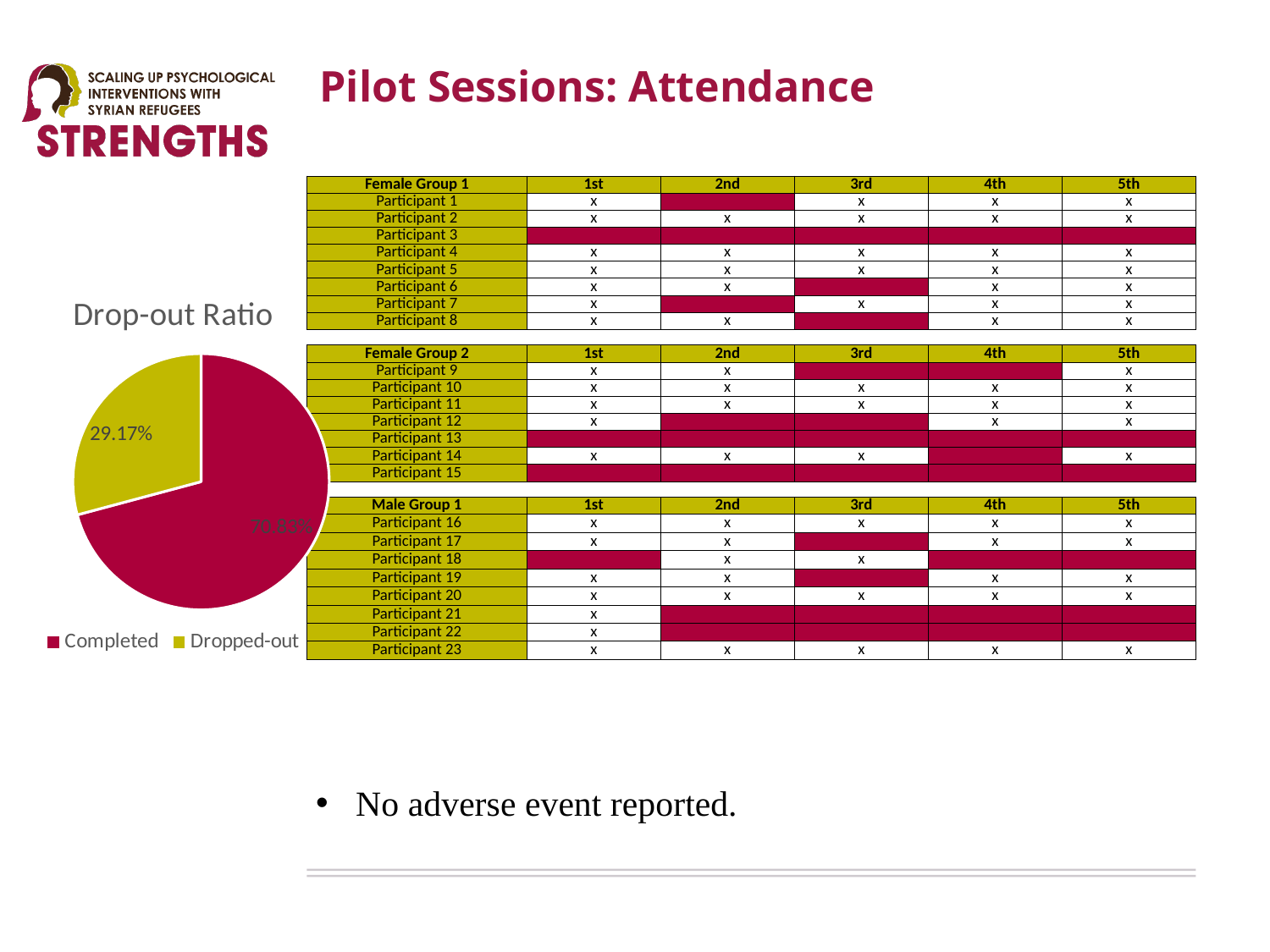
What is the title of the pie chart? Drop-out Ratio What kind of chart is shown on the slide? pie chart Which colour represents Dropped-out in the pie chart? yellow-green Is the Dropped-out share in the pie chart greater or less than 50%? less What share of the pie chart is labelled Dropped-out? 29.17% Which slice of the pie chart is the largest? Completed How many slices does the pie chart have? 2 Which slice of the pie chart is the smallest? Dropped-out How many entries does the pie chart legend list? 2 Which is larger in the pie chart, Completed or Dropped-out? Completed